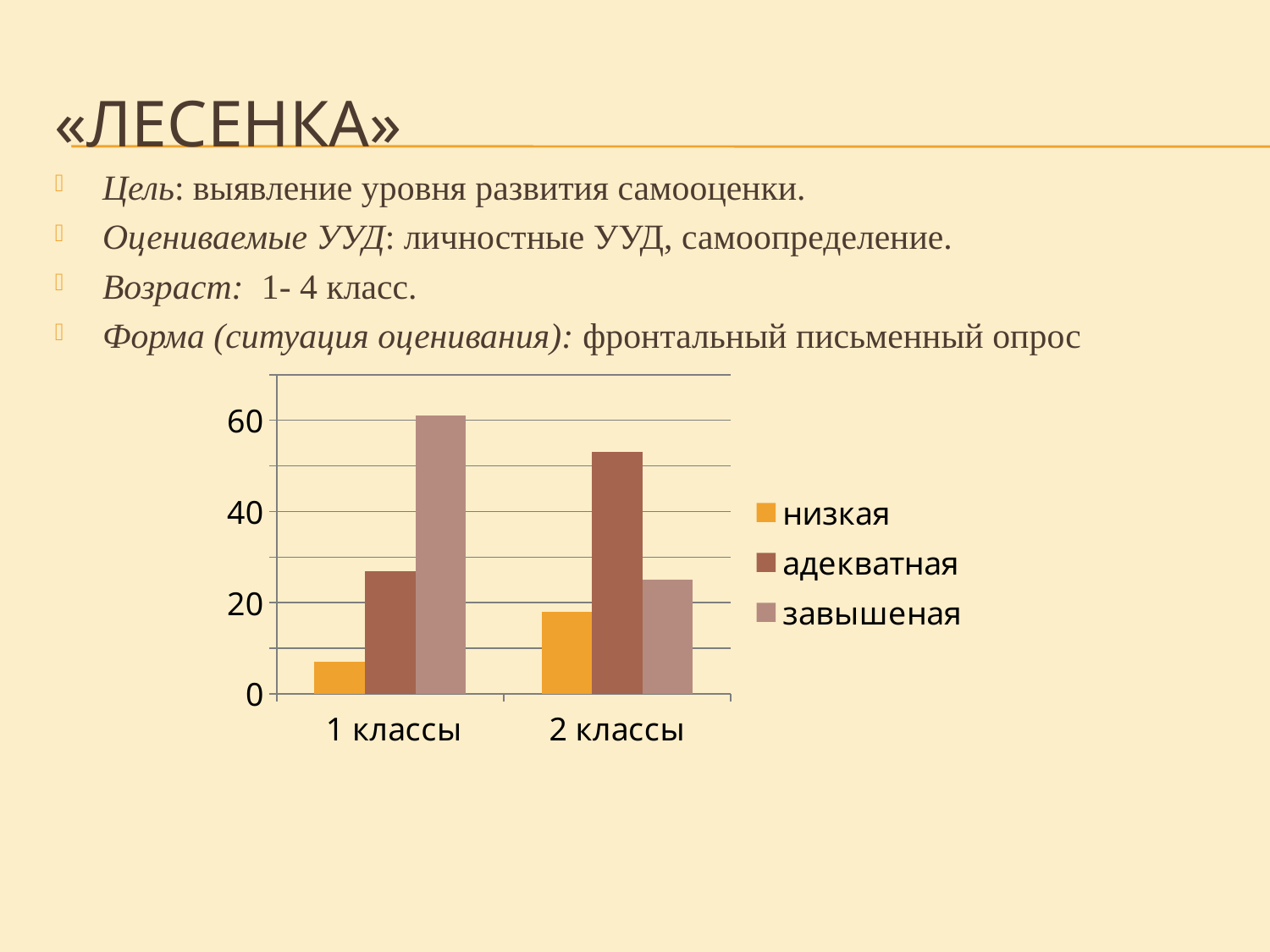
Which category has the larger value for завышеная, 1 классы or 2 классы? 1 классы Is the value of завышеная for 1 классы greater or less than 40? greater Which series has the highest value for 1 классы? завышеная Which series has the lowest value for 1 классы? низкая What kind of chart is shown on the slide? bar chart Is the value of адекватная for 2 классы greater or less than 40? greater Which legend entry is shown in the orange colour? низкая How many series does the chart legend list? 3 Which series has the highest value for 2 классы? адекватная How many categories are shown on the x axis of the chart? 2 Does the value of низкая rise or fall from 1 классы to 2 классы? rise Is the value of низкая for 1 классы greater or less than 20? less